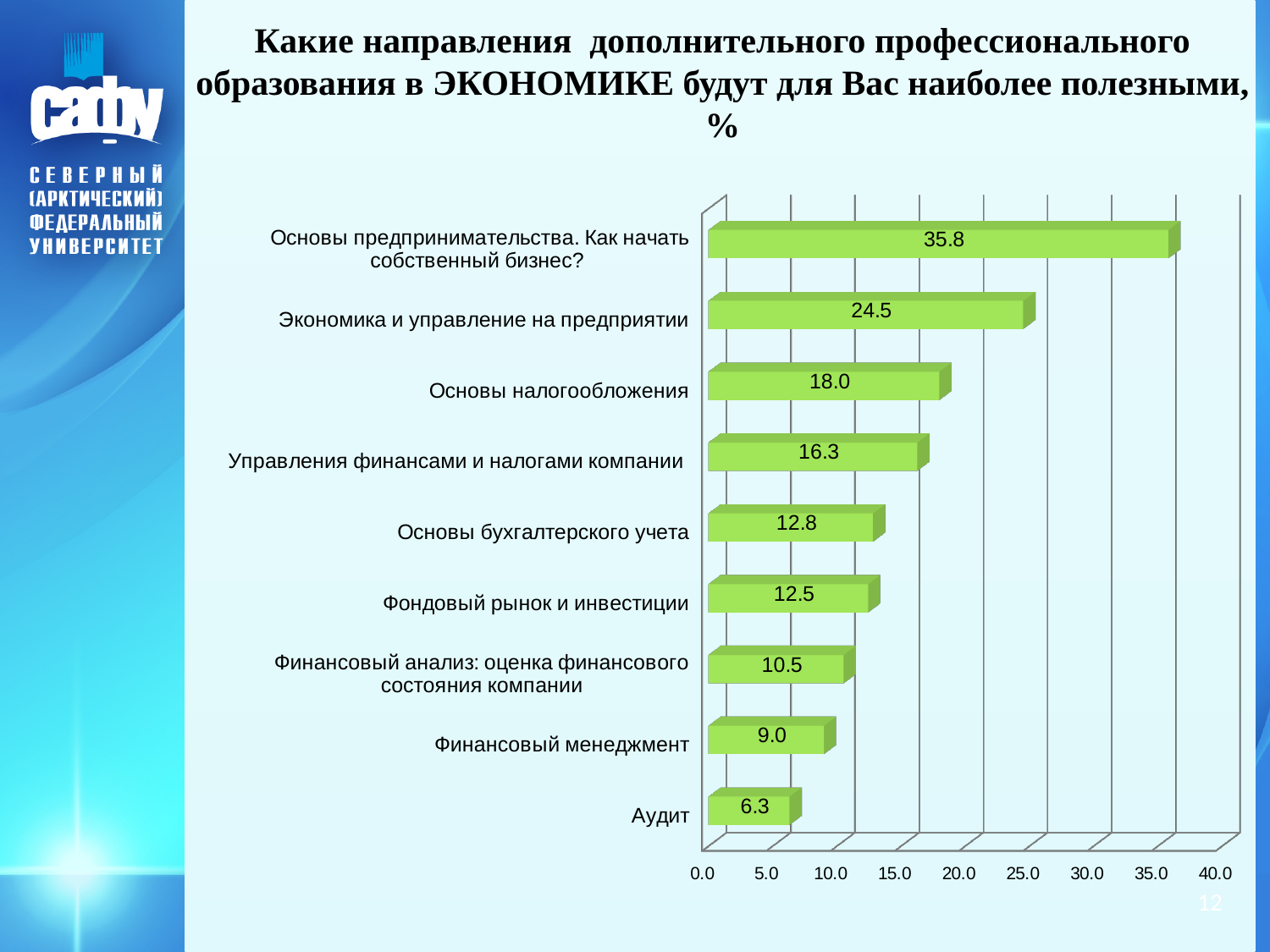
What kind of chart is shown on the slide? bar chart What is the value for "Аудит"? 6.3 What is the difference between the values for "Основы бухгалтерского учета" and "Аудит"? 6.5 Which is larger: the value for "Финансовый менеджмент" or the value for "Финансовый анализ: оценка финансового состояния компании"? Финансовый анализ: оценка финансового состояния компании Is the value for "Управления финансами и налогами компании" greater or less than 15.0? greater Which category has the lowest value? Аудит What is the maximum value shown on the horizontal axis? 40.0 What is the difference between the values for "Основы предпринимательства. Как начать собственный бизнес?" and "Экономика и управление на предприятии"? 11.3 Which category has the highest value? Основы предпринимательства. Как начать собственный бизнес? What is the value for "Основы налогообложения"? 18.0 How many categories are shown in the chart? 9 What is the value for "Фондовый рынок и инвестиции"? 12.5